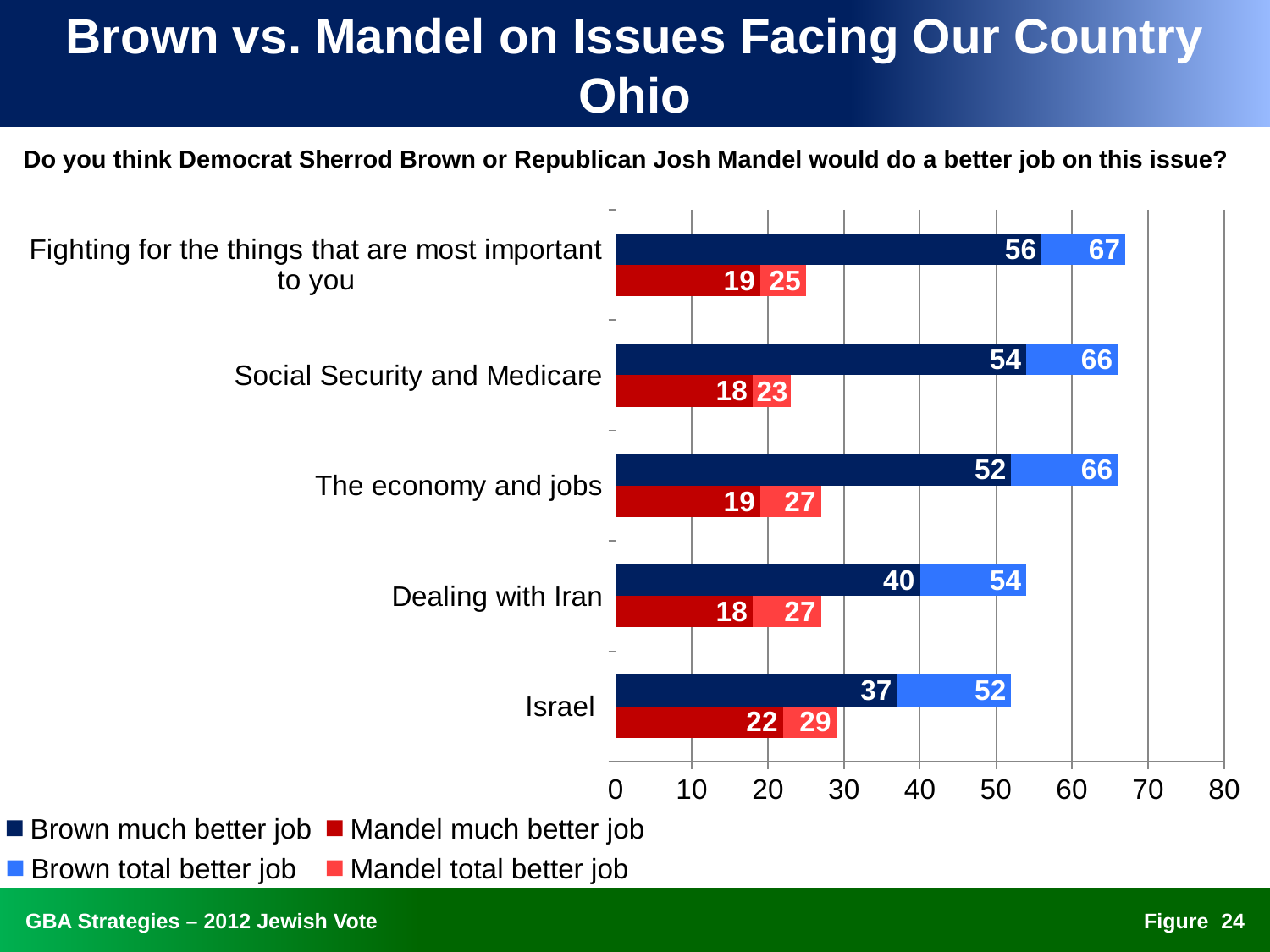
What is the value for "Mandel total better job" on The economy and jobs? 27 What is the value for "Brown much better job" on Dealing with Iran? 40 What is the value for "Mandel much better job" on Israel? 22 How many issues are shown on the chart? 5 Which issue has the highest value for "Brown total better job"? Fighting for the things that are most important to you What colour represents "Mandel much better job" in the legend? Dark red How many series does the legend list? 4 What kind of chart is shown on the slide? Bar chart Which is larger on Israel: "Brown much better job" or "Mandel total better job"? Brown much better job What is the value for "Brown total better job" on Fighting for the things that are most important to you? 67 What is the difference between "Brown total better job" and "Mandel total better job" on Social Security and Medicare? 43 Which issue has the lowest value for "Brown much better job"? Israel